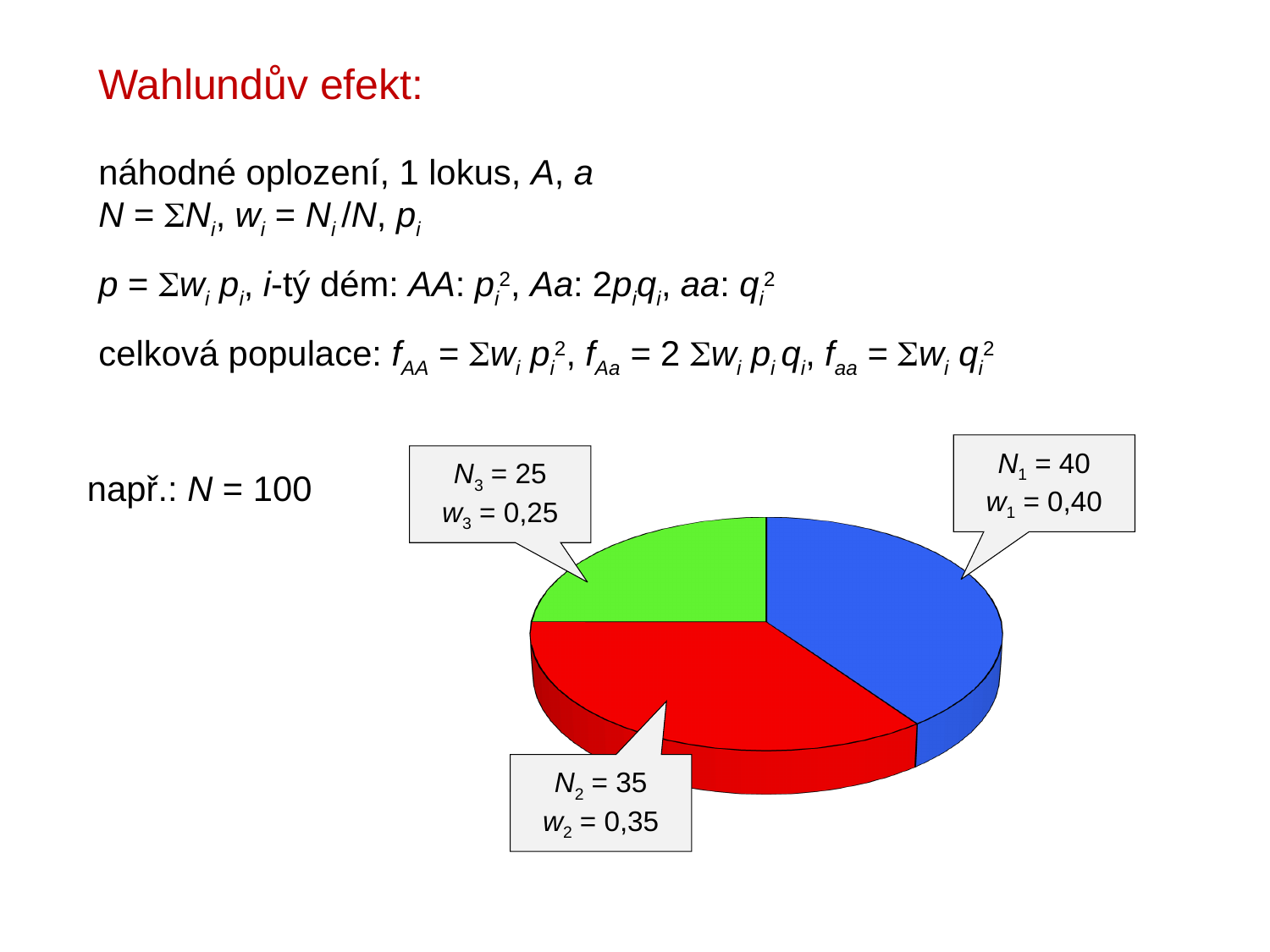
What is the value of w2 shown for the red slice? 0,35 What share of the pie does the blue slice (N1) represent, as given by w1? 0,40 How many slices does the pie chart have? 3 Which slice of the pie chart is the smallest? N3 (green) What kind of chart is shown on the slide? pie chart What is the value of N2 shown in the callout for the red slice? 35 What is the value of N1 shown in the callout for the blue slice? 40 What is the difference between N1 and N3? 15 Which is larger, N2 or N3? N2 What is the value of N3 shown in the callout for the green slice? 25 Which slice of the pie chart is the largest? N1 (blue) What colour is the slice labelled N3 = 25? green